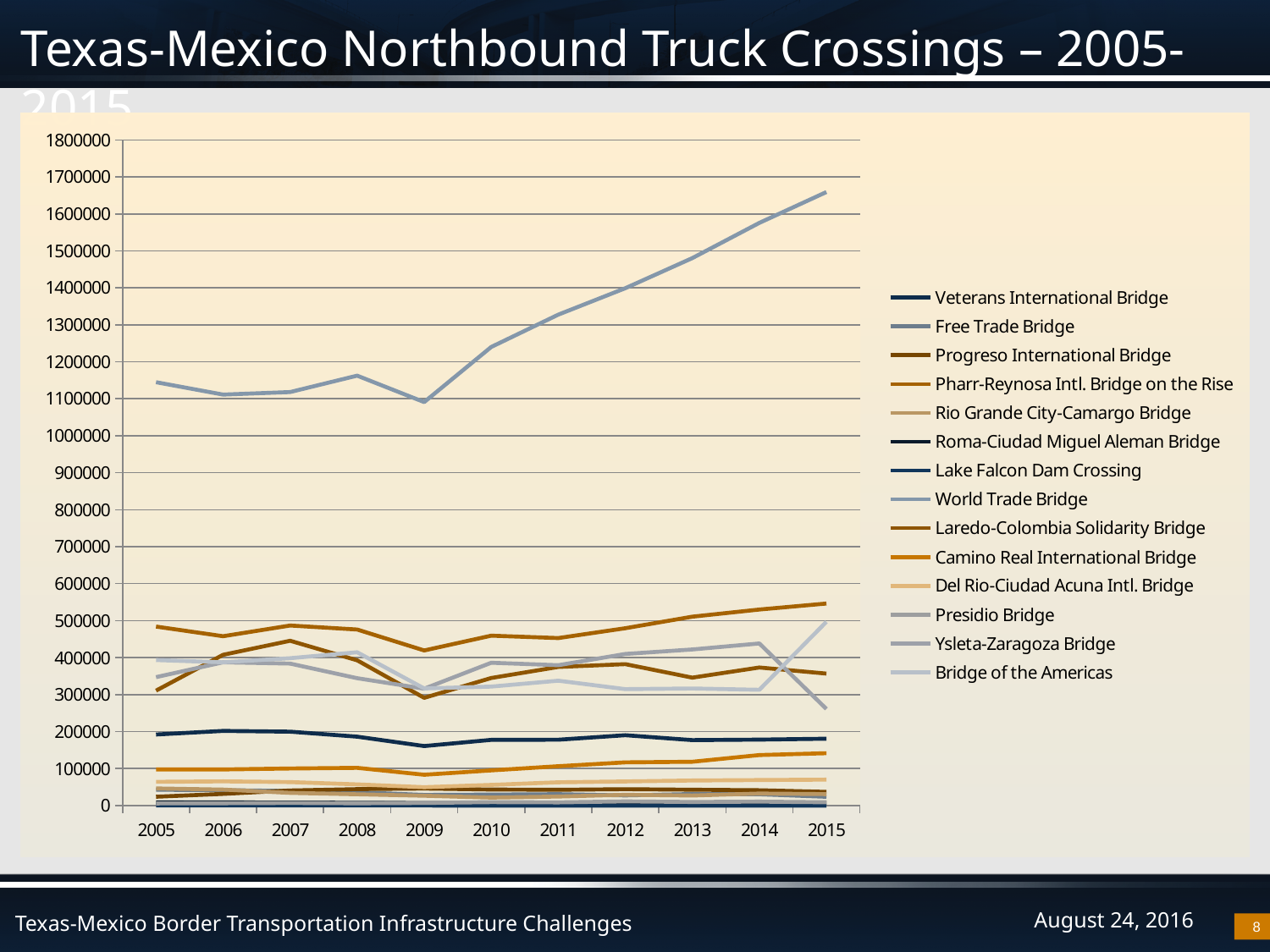
Does the World Trade Bridge line rise or fall overall from 2005 to 2015? rise In which year does the World Trade Bridge line reach its lowest point? 2009 Is the value for World Trade Bridge in 2015 greater or less than 1600000? greater Is the value for World Trade Bridge in 2011 greater or less than 1300000? greater How many series does the legend list? 14 Is the value for Pharr-Reynosa Intl. Bridge on the Rise in 2015 greater or less than 500000? greater How many years are shown along the x axis? 11 Which bridge has the highest number of northbound truck crossings across the whole period? World Trade Bridge What is the first year shown on the x axis? 2005 Which is larger in 2015, the value for World Trade Bridge or the value for Pharr-Reynosa Intl. Bridge on the Rise? World Trade Bridge What kind of chart is shown on the slide? line chart What is the last entry listed in the legend? Bridge of the Americas